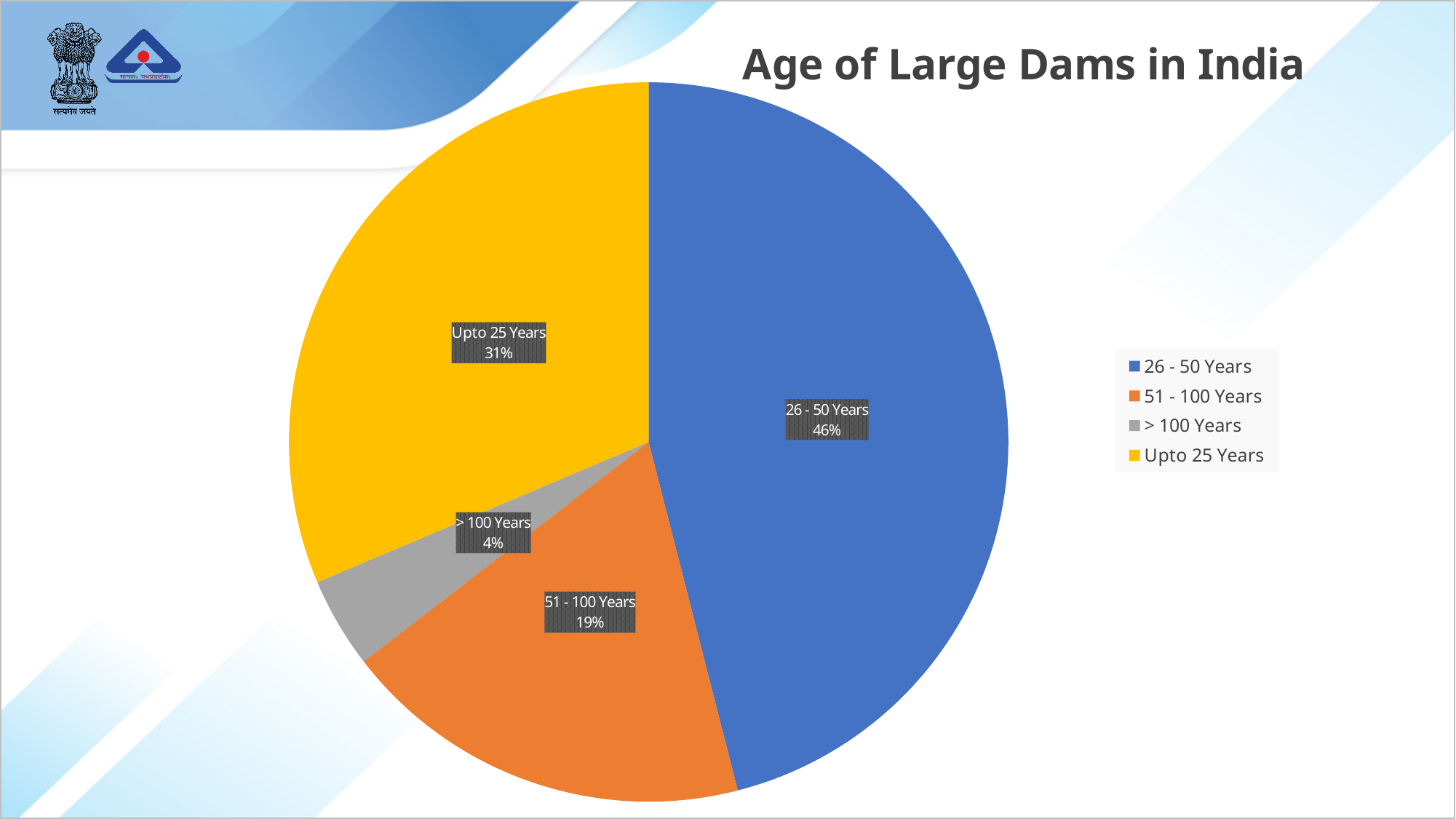
What kind of chart is shown on the slide? Pie chart What percentage of large dams are more than 100 years old? 4% What percentage of large dams are Upto 25 Years old? 31% What share of the pie is the 51 - 100 Years slice? 19% What colour represents the > 100 Years category in the legend? Grey Which age category has the smallest share of large dams? > 100 Years How many age categories are shown in the pie chart? 4 Which age category has the largest share of large dams? 26 - 50 Years What is the difference in percentage points between the 26 - 50 Years and Upto 25 Years slices? 15% What is the title of the chart? Age of Large Dams in India Which is larger: the share for 51 - 100 Years or the share for Upto 25 Years? Upto 25 Years What share of large dams in India are 26 - 50 years old? 46%